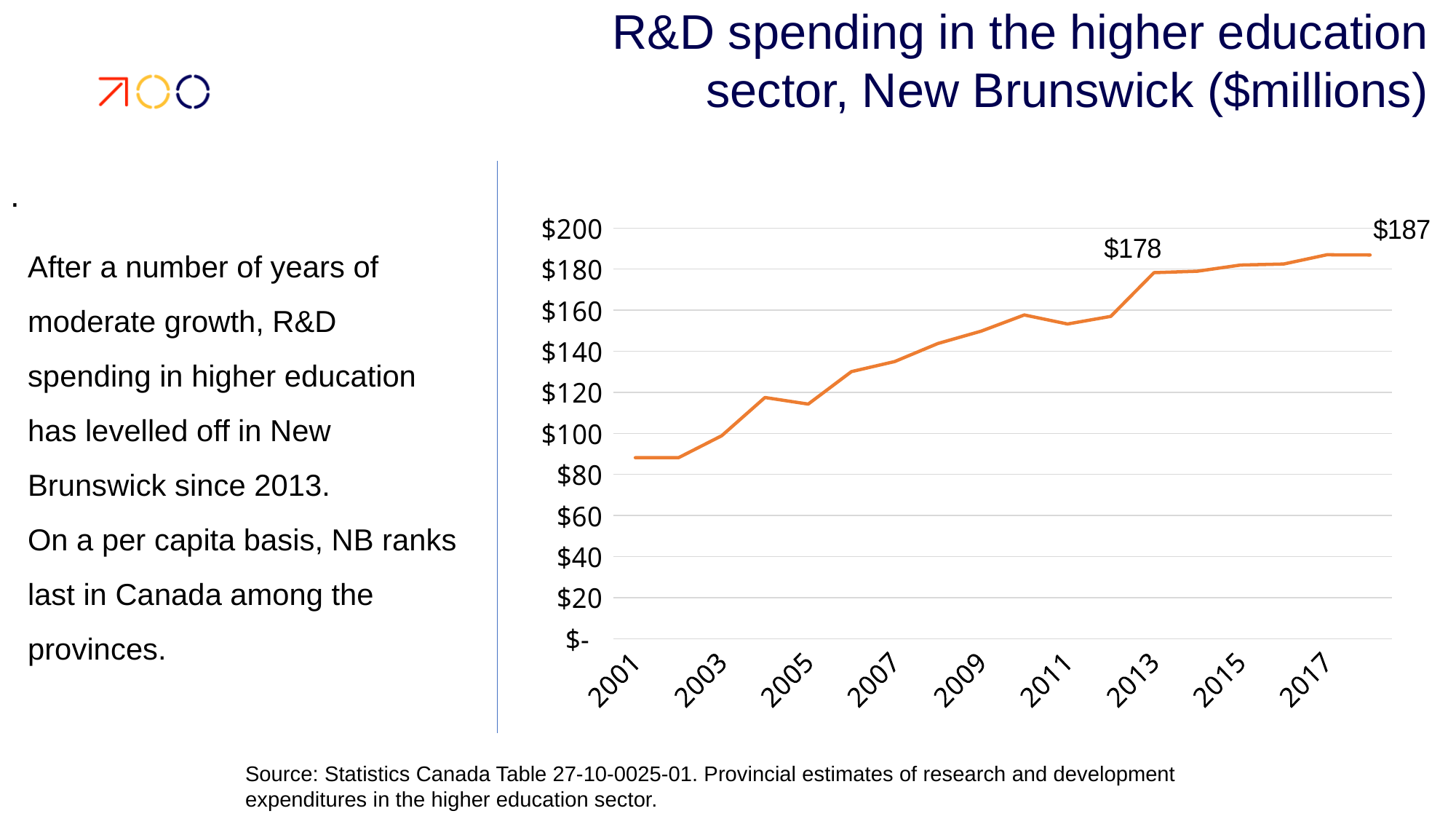
What is the difference between the labelled value at the last point ($187) and the value for 2013 ($178)? $9 Is the value for 2011 greater or less than $140? greater What is the title of the chart? R&D spending in the higher education sector, New Brunswick ($millions) What is the value labelled at the last point of the line? $187 Which year has the higher R&D spending, 2001 or 2013? 2013 Is the value for 2015 greater or less than $160? greater What is the R&D spending value labelled for 2013? $178 Is the value for 2001 greater or less than $100? less What kind of chart is shown on the slide? line chart Do the values generally rise or fall from 2001 to the end of the series? rise